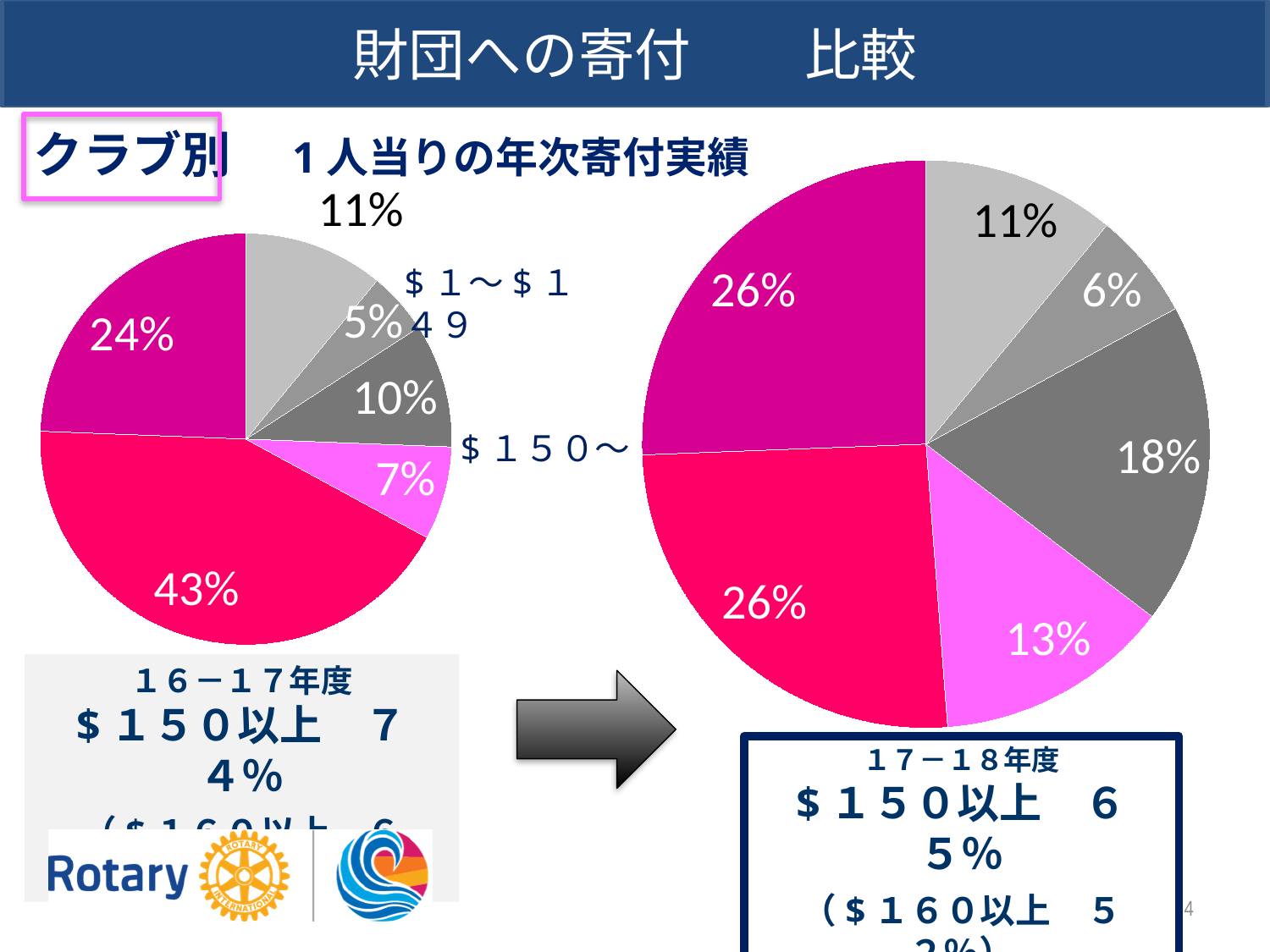
How many slices does the left pie chart (16－17年度) have? 6 In the left pie chart (16－17年度), what is the smallest slice's share? 5% In the right pie chart (17－18年度), which is larger: the dark grey slice or the light magenta slice? the dark grey slice (18%) In the left pie chart (16－17年度), what share does the light magenta (pink) slice have? 7% In the right pie chart (17－18年度), what is the smallest slice's share? 6% What kind of chart is shown on the left side of the slide (16－17年度)? pie chart In the right pie chart (17－18年度), what share does the dark grey slice have? 18% In the right pie chart (17－18年度), what share does the light grey slice have? 11% How many slices does the right pie chart (17－18年度) have? 6 In the left pie chart (16－17年度), what is the difference between the largest slice (43%) and the dark magenta slice (24%)? 19 percentage points In the left pie chart (16－17年度), what is the largest slice's share? 43% Which fiscal year does the right pie chart represent? 17－18年度